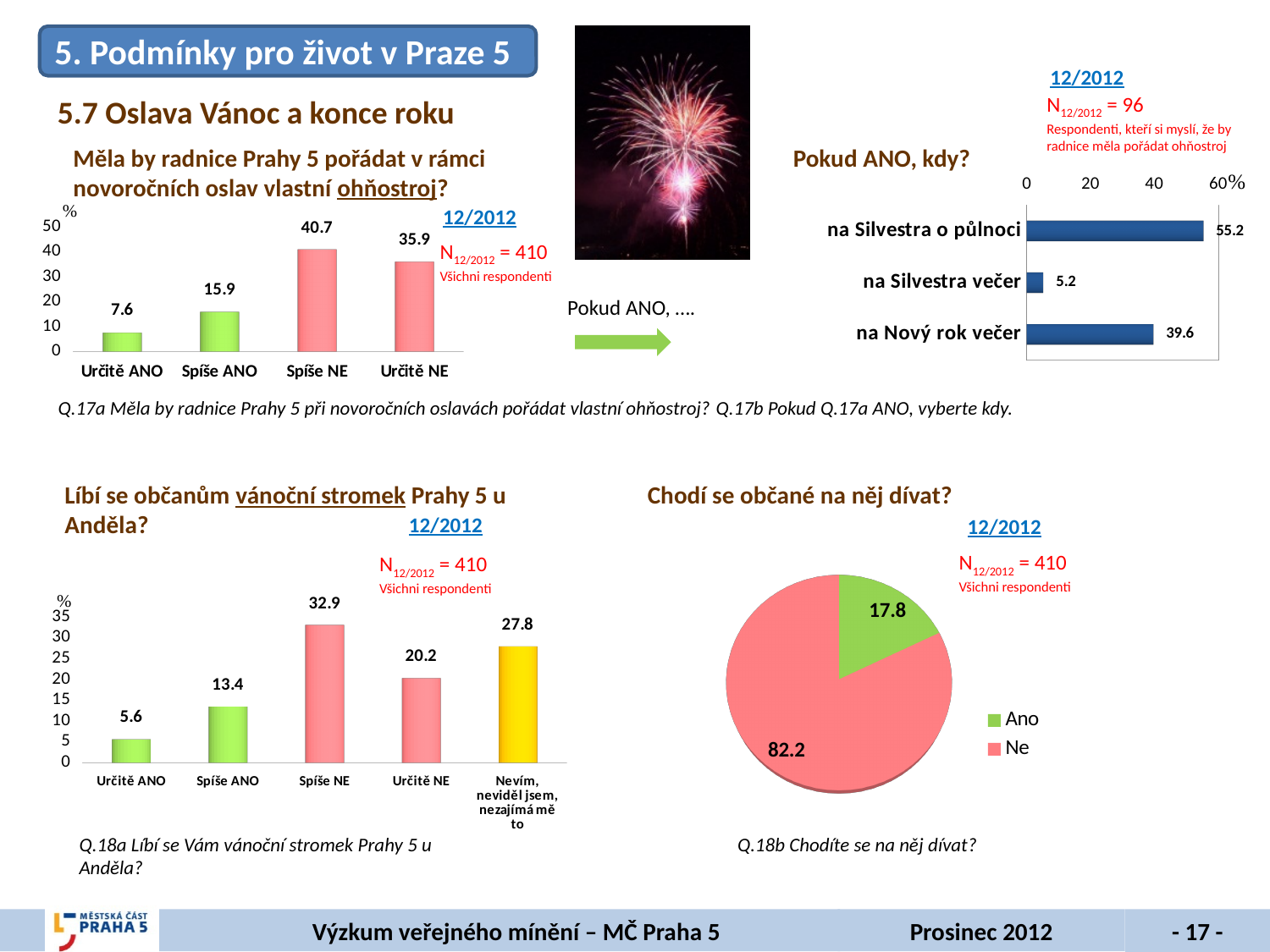
In the bottom-left chart 'Líbí se občanům vánoční stromek Prahy 5 u Anděla?', which is larger: 'Spíše ANO' or 'Nevím, neviděl jsem, nezajímá mě to'? Nevím, neviděl jsem, nezajímá mě to In the bottom-left chart 'Líbí se občanům vánoční stromek Prahy 5 u Anděla?', what is the value for 'Určitě NE'? 20.2 What kind of chart is the bottom-right chart 'Chodí se občané na něj dívat?'? pie chart In the top-left chart 'Měla by radnice Prahy 5 pořádat v rámci novoročních oslav vlastní ohňostroj?', which category has the lowest value? Určitě ANO In the bottom-left chart 'Líbí se občanům vánoční stromek Prahy 5 u Anděla?', how many categories are shown? 5 In the top-left chart 'Měla by radnice Prahy 5 pořádat v rámci novoročních oslav vlastní ohňostroj?', what is the value for 'Spíše NE'? 40.7 In the bottom-left chart 'Líbí se občanům vánoční stromek Prahy 5 u Anděla?', which category has the highest value? Spíše NE In the top-right chart 'Pokud ANO, kdy?', which category has the highest value? na Silvestra o půlnoci In the top-left chart 'Měla by radnice Prahy 5 pořádat v rámci novoročních oslav vlastní ohňostroj?', what is the difference between 'Spíše NE' and 'Určitě NE'? 4.8 In the bottom-right pie chart 'Chodí se občané na něj dívat?', what is the value for 'Ne'? 82.2 In the top-right chart 'Pokud ANO, kdy?', what is the value for 'na Nový rok večer'? 39.6 In the top-right chart 'Pokud ANO, kdy?', how many categories are shown? 3